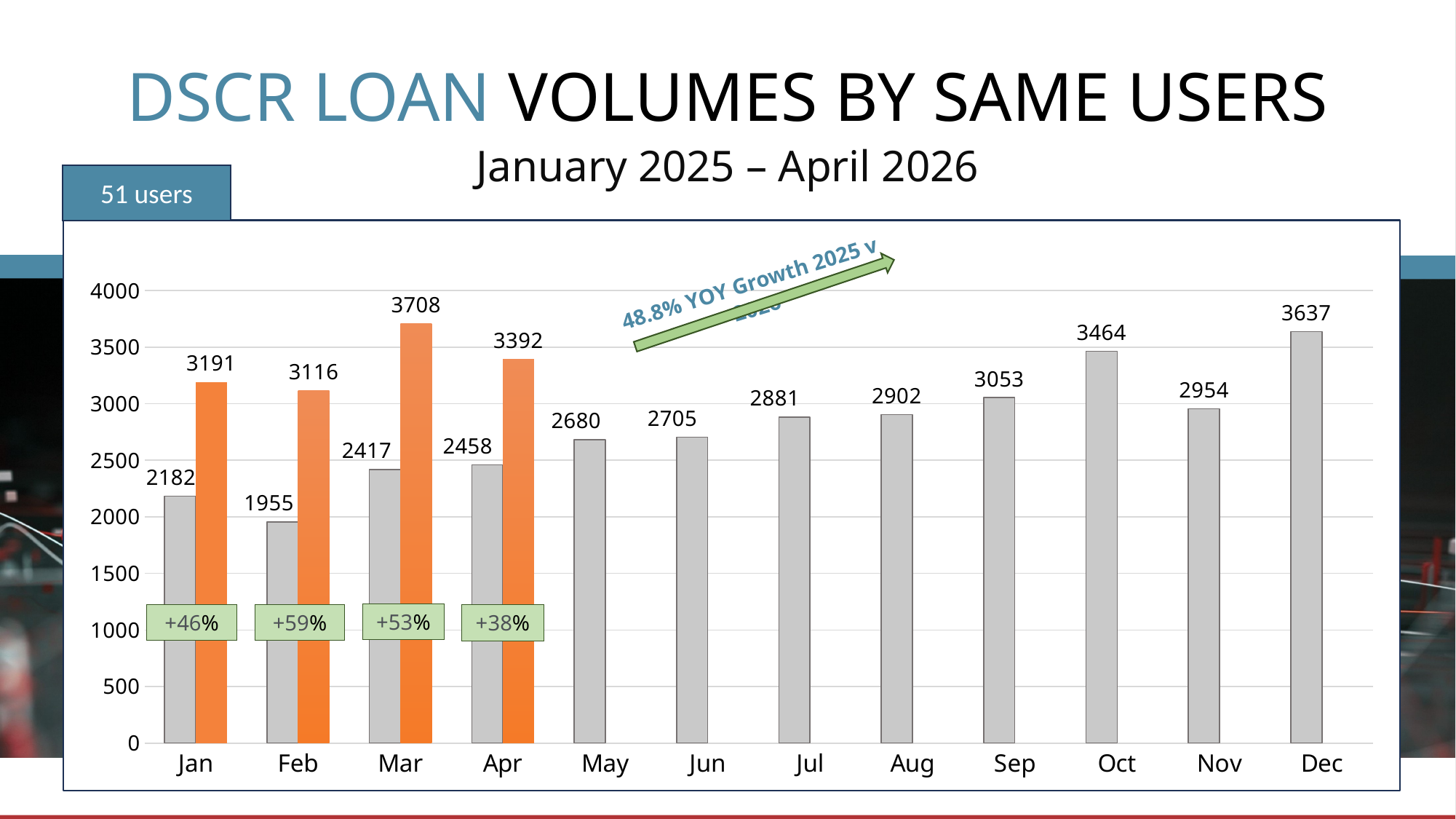
How many months are shown on the x axis? 12 What is the value of the orange bar for Mar? 3708 What kind of chart is shown on the slide? Bar chart Do the gray bars rise or fall from May to Oct? Rise What is the difference between the orange bar and the gray bar for Mar? 1291 Which month has the lowest gray bar? Feb What is the value of the gray bar for Oct? 3464 What is the value of the gray bar for Feb? 1955 Which month has the highest gray bar? Dec Which is larger, the gray bar for Oct or the gray bar for Nov? Oct What percentage growth label is shown above the Feb bars? +59% Which month has the highest orange bar? Mar